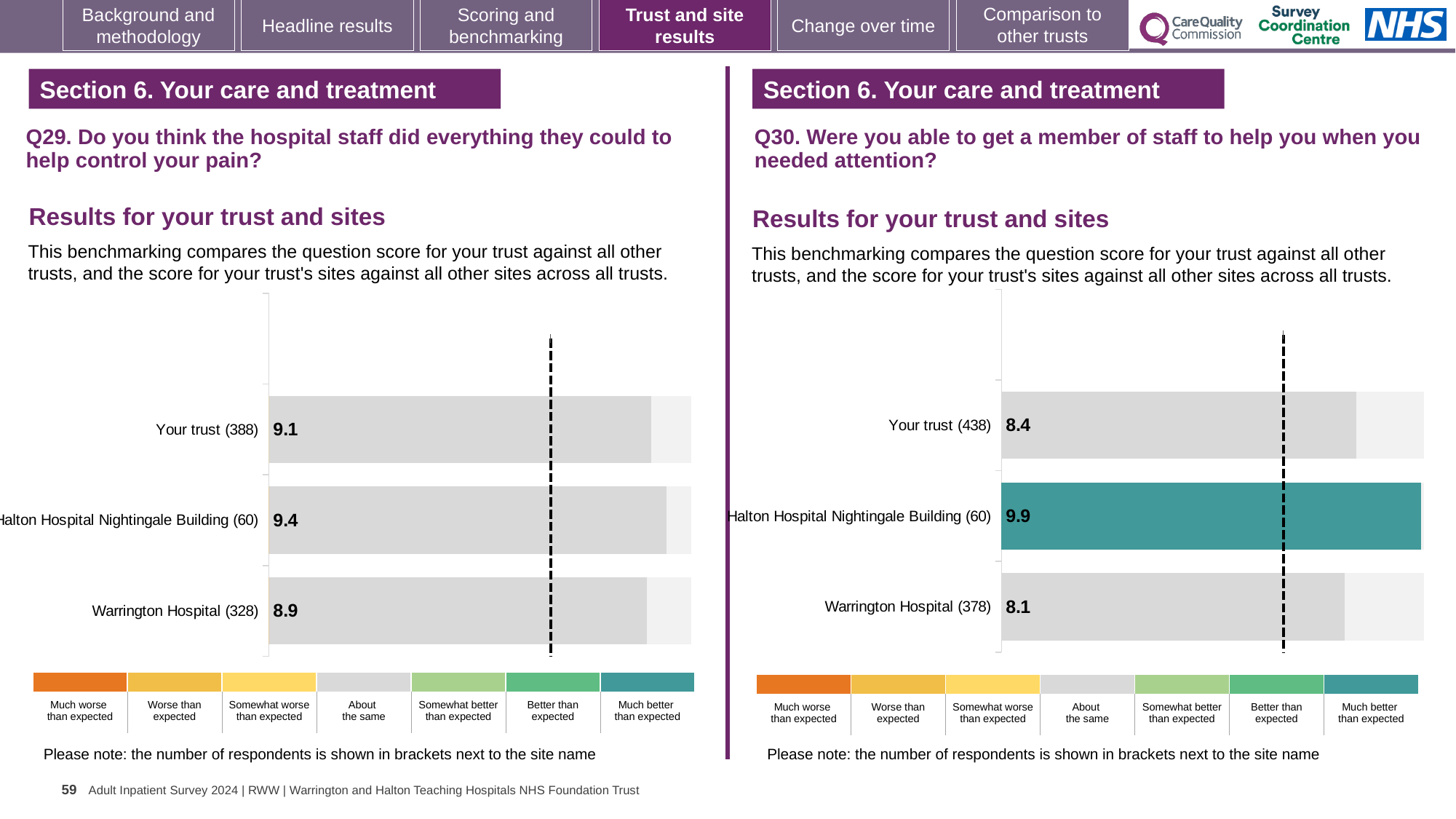
In the Q29 chart on the left, what is the difference between the scores for Halton Hospital Nightingale Building and Warrington Hospital? 0.5 In the Q30 chart on the right, what is the difference between the scores for Halton Hospital Nightingale Building and Warrington Hospital? 1.8 In the Q30 chart on the right, what is the score for Your trust (438)? 8.4 In the Q30 chart on the right, what is the score for Halton Hospital Nightingale Building (60)? 9.9 In the Q29 chart on the left, what is the score for Warrington Hospital (328)? 8.9 How many bars are plotted in the Q29 chart on the left? 3 In the Q29 chart on the left, what is the score for Your trust (388)? 9.1 In the Q30 chart on the right, which benchmark category does the colour of the Halton Hospital Nightingale Building bar correspond to? Much better than expected What type of chart is used for the Q30 results on the right? Bar chart In the Q30 chart on the right, which site or trust has the lowest score? Warrington Hospital (378) In the Q29 chart on the left, which site or trust has the highest score? Halton Hospital Nightingale Building (60) In the Q30 chart on the right, which has the larger score: Your trust or Warrington Hospital? Your trust